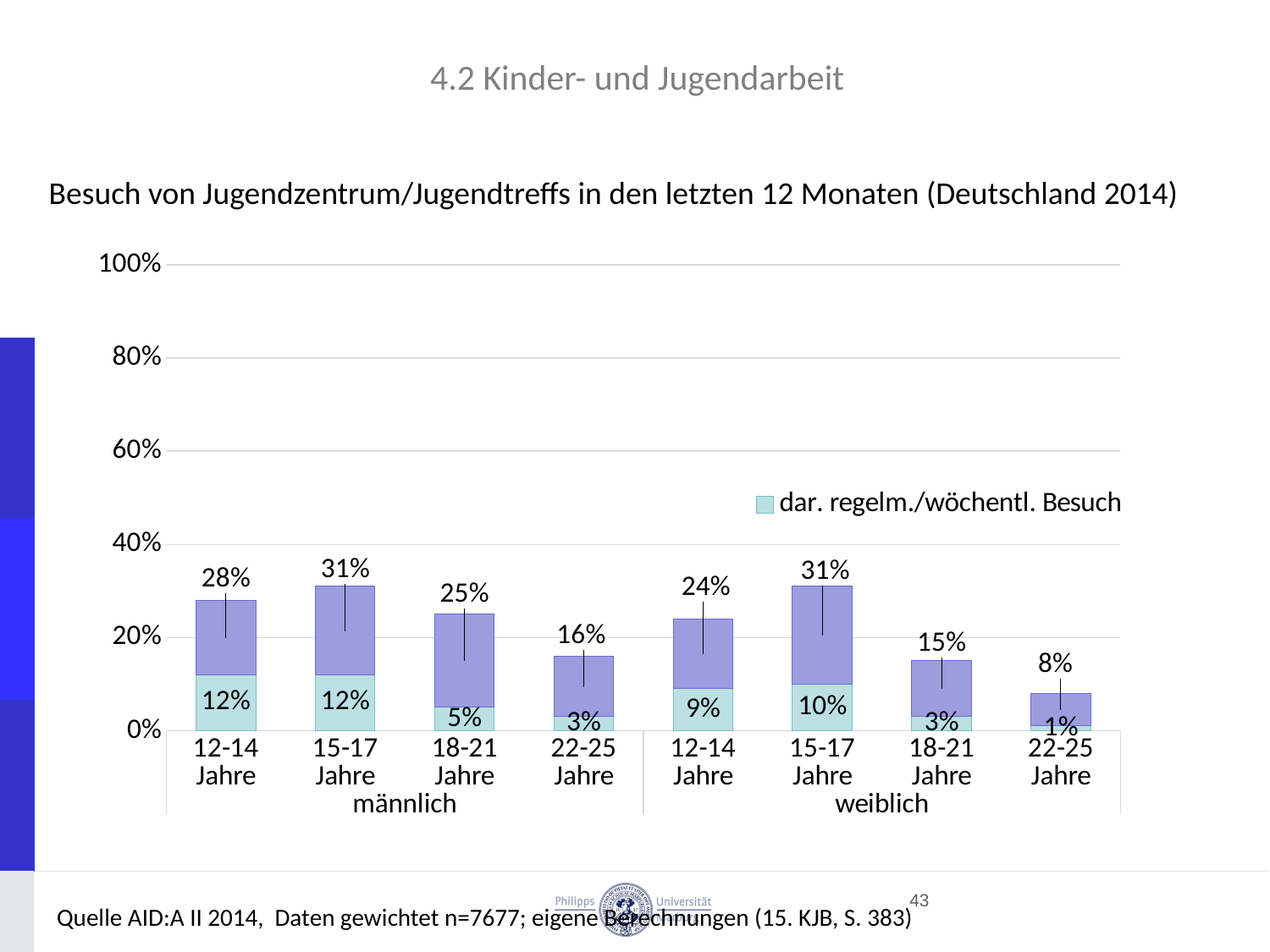
What is the legend entry shown on the chart? dar. regelm./wöchentl. Besuch Which age group in the weiblich section has the lowest overall visit value? 22-25 Jahre What is the regular/weekly visit (dar. regelm./wöchentl. Besuch) value for 15-17 Jahre in the weiblich group? 10% How many age-group bars are shown in the chart in total? 8 What is the difference between the overall visit values for 18-21 Jahre männlich and 18-21 Jahre weiblich? 10% Which age group in the männlich section has the highest overall visit value? 15-17 Jahre What is the overall visit value for 12-14 Jahre in the männlich group? 28% What is the overall visit value for 22-25 Jahre in the weiblich group? 8% Is the overall visit value for 15-17 Jahre weiblich greater or less than 20%? greater What kind of chart is shown on the slide? bar chart Within the weiblich group, do the overall visit values rise or fall from 15-17 Jahre to 22-25 Jahre? fall Which is larger: the overall visit value for 12-14 Jahre männlich or 12-14 Jahre weiblich? 12-14 Jahre männlich